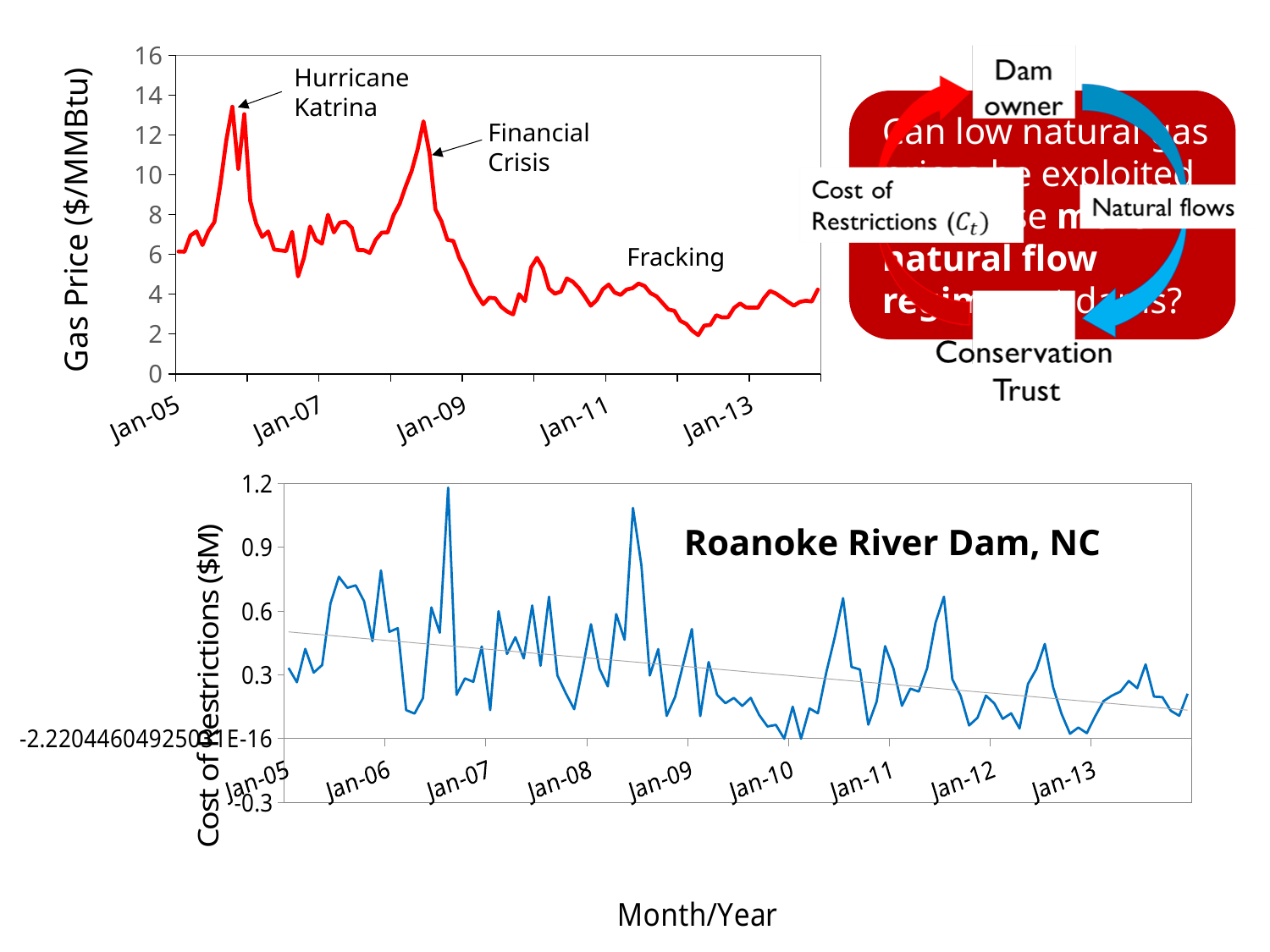
In the top-left gas price chart, what is the label on the vertical axis? Gas Price ($/MMBtu) In the top-left gas price chart, is the gas price at the Financial Crisis peak greater or less than 10? greater In the top-left gas price chart, which annotated event has the higher peak gas price, Hurricane Katrina or the Financial Crisis? Hurricane Katrina In the bottom Roanoke River Dam, NC chart, is the cost of restrictions at Jan-10 greater or less than 0.3? less In the top-left gas price chart, does the gas price generally rise or fall from the Financial Crisis peak to Jan-13? fall In the bottom Roanoke River Dam, NC chart, is the highest peak of the cost of restrictions greater or less than 0.9? greater In the bottom Roanoke River Dam, NC chart, what is the label on the horizontal axis? Month/Year What kind of chart is the top-left chart showing gas price? line chart In the bottom Roanoke River Dam, NC chart, does the straight trend line rise or fall from Jan-05 to Jan-13? fall What kind of chart is the bottom chart titled Roanoke River Dam, NC? line chart